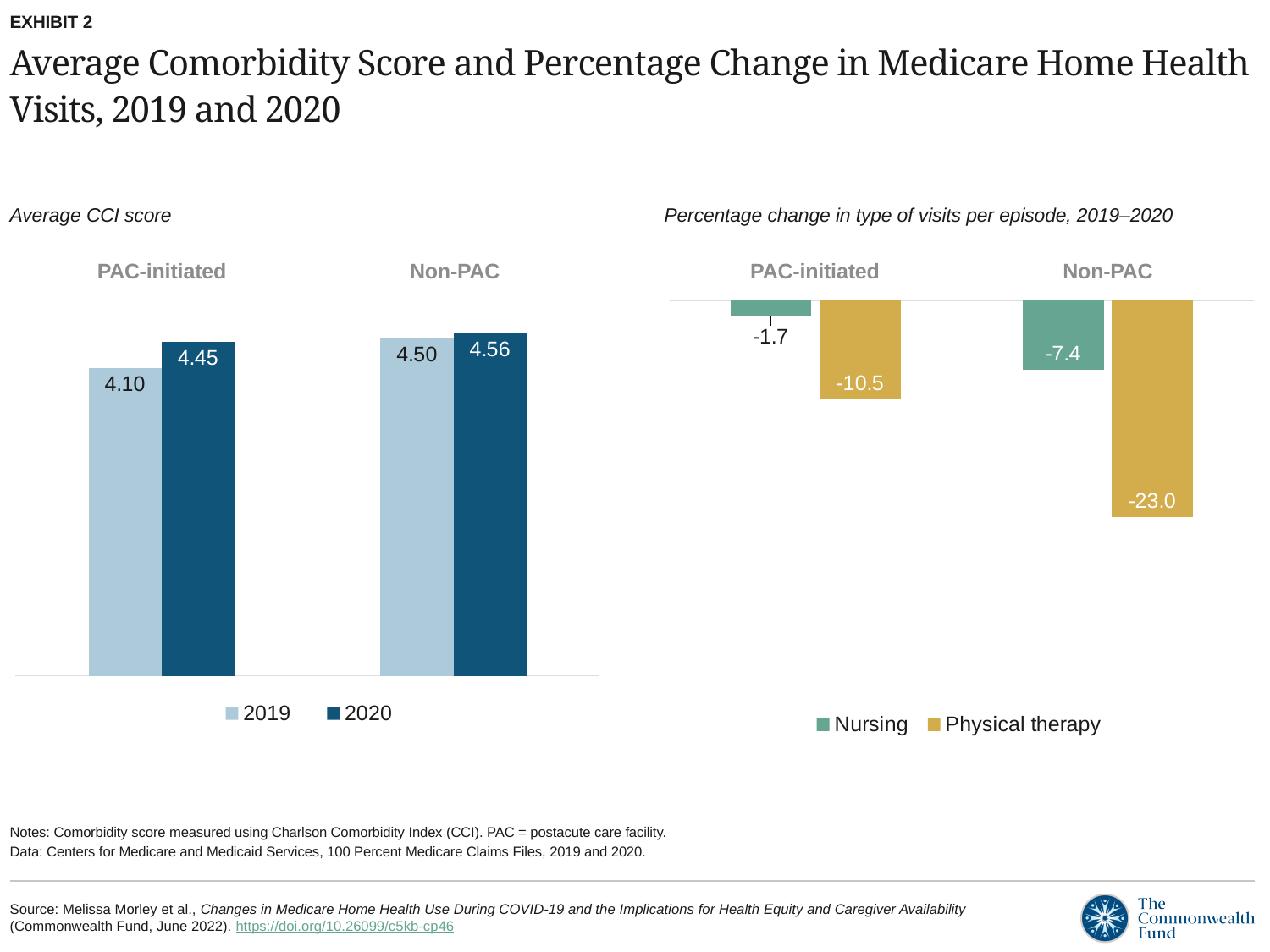
In the 'Percentage change in type of visits per episode, 2019–2020' chart, what is the Physical therapy value for Non-PAC? -23.0 In the 'Percentage change in type of visits per episode, 2019–2020' chart, what is the Nursing value for PAC-initiated? -1.7 In the 'Percentage change in type of visits per episode, 2019–2020' chart, how many categories are shown on the x axis? 2 In the 'Average CCI score' chart, how many series does the legend list? 2 In the 'Average CCI score' chart, what is the 2020 value for Non-PAC? 4.56 In the 'Average CCI score' chart, what is the 2019 value for PAC-initiated? 4.10 What kind of chart is the 'Average CCI score' chart? Bar chart In the 'Percentage change in type of visits per episode, 2019–2020' chart, which category and series has the lowest value? Non-PAC, Physical therapy In the 'Percentage change in type of visits per episode, 2019–2020' chart, what colour represents Physical therapy? Gold In the 'Average CCI score' chart, which is larger: the 2019 value for PAC-initiated or the 2019 value for Non-PAC? Non-PAC In the 'Average CCI score' chart, what is the difference between the 2020 and 2019 values for PAC-initiated? 0.35 In the 'Percentage change in type of visits per episode, 2019–2020' chart, what is the difference between the Physical therapy and Nursing values for PAC-initiated? 8.8